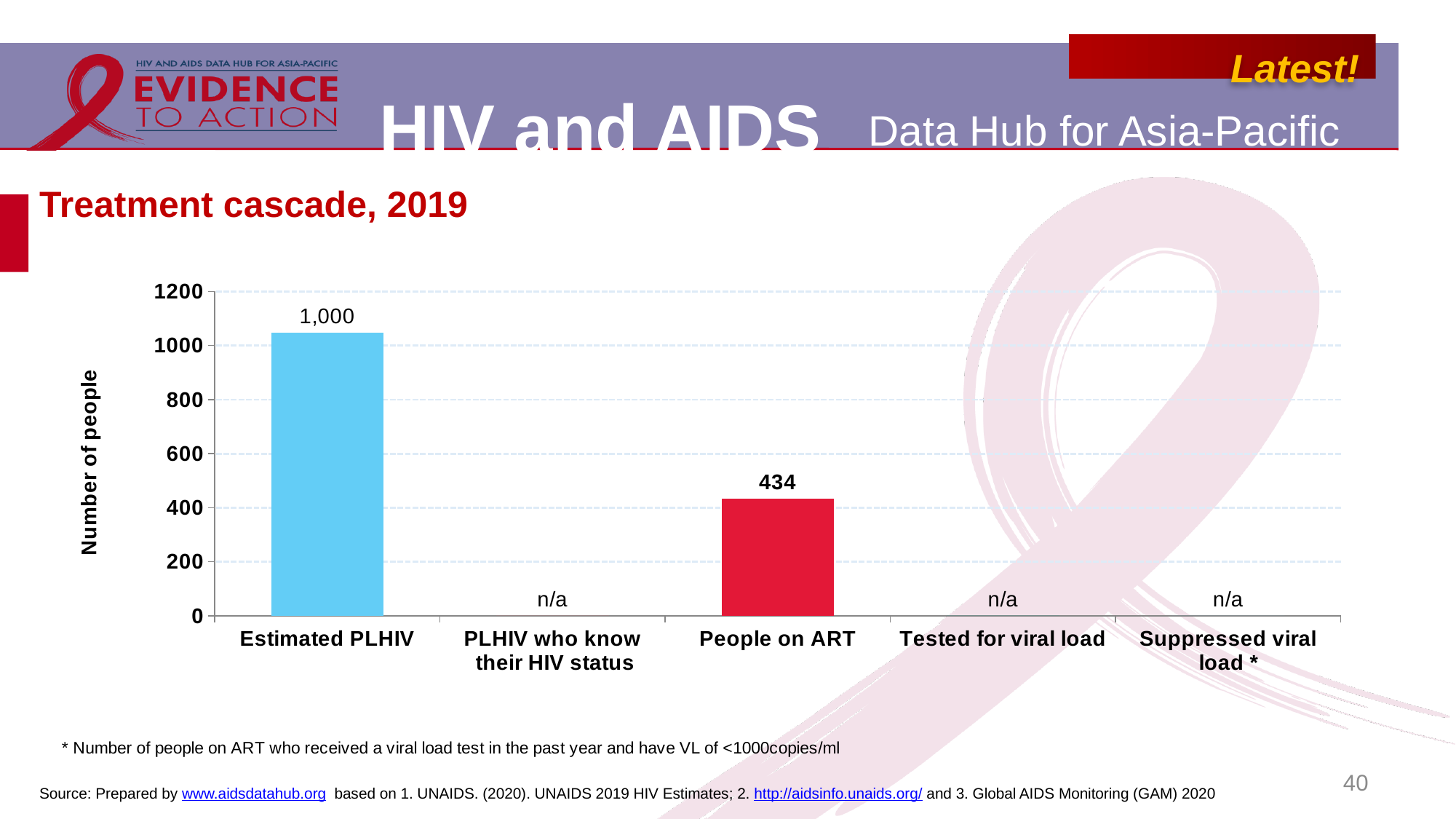
What is shown for Tested for viral load? n/a What is shown for PLHIV who know their HIV status? n/a What is the title of the chart? Treatment cascade, 2019 Which is larger, Estimated PLHIV or People on ART? Estimated PLHIV Is the value for People on ART greater or less than 600? less What kind of chart is this? bar chart What is shown for Suppressed viral load? n/a Which category has the highest value? Estimated PLHIV What is the value for People on ART? 434 How many categories are shown on the x axis? 5 What is the value for Estimated PLHIV? 1,000